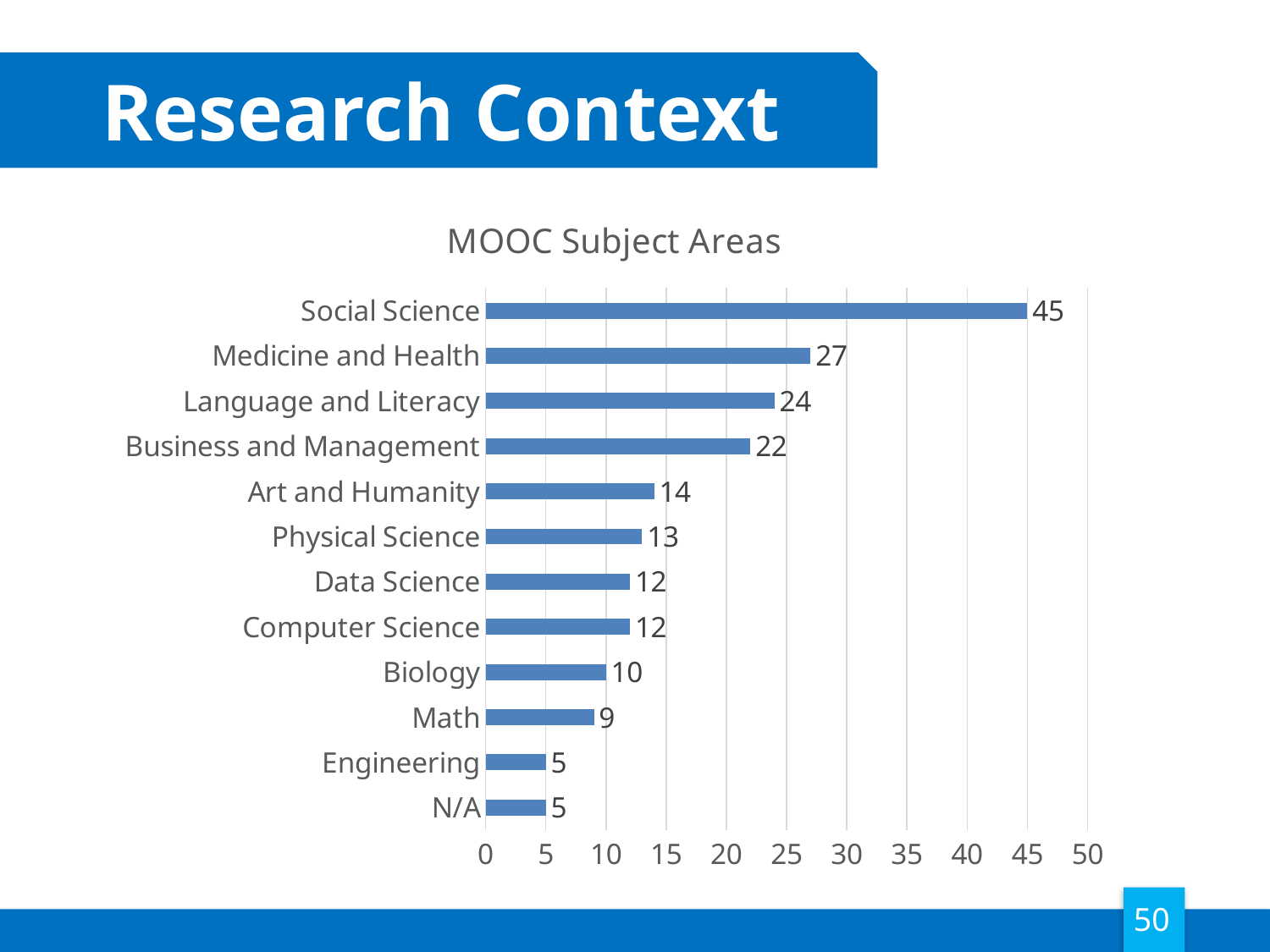
How many subject areas are shown in the chart? 12 Which is larger, the value for Physical Science or the value for Biology? Physical Science What is the difference between the values for Language and Literacy and Art and Humanity? 10 What is the title of the chart? MOOC Subject Areas Is the value for Business and Management greater or less than 20? greater What is the value for Social Science? 45 What kind of chart is shown on the slide? Bar chart What is the difference between the values for Social Science and Medicine and Health? 18 What is the value for Math? 9 What is the value for Medicine and Health? 27 Which subject area has the highest value? Social Science What is the value for Business and Management? 22